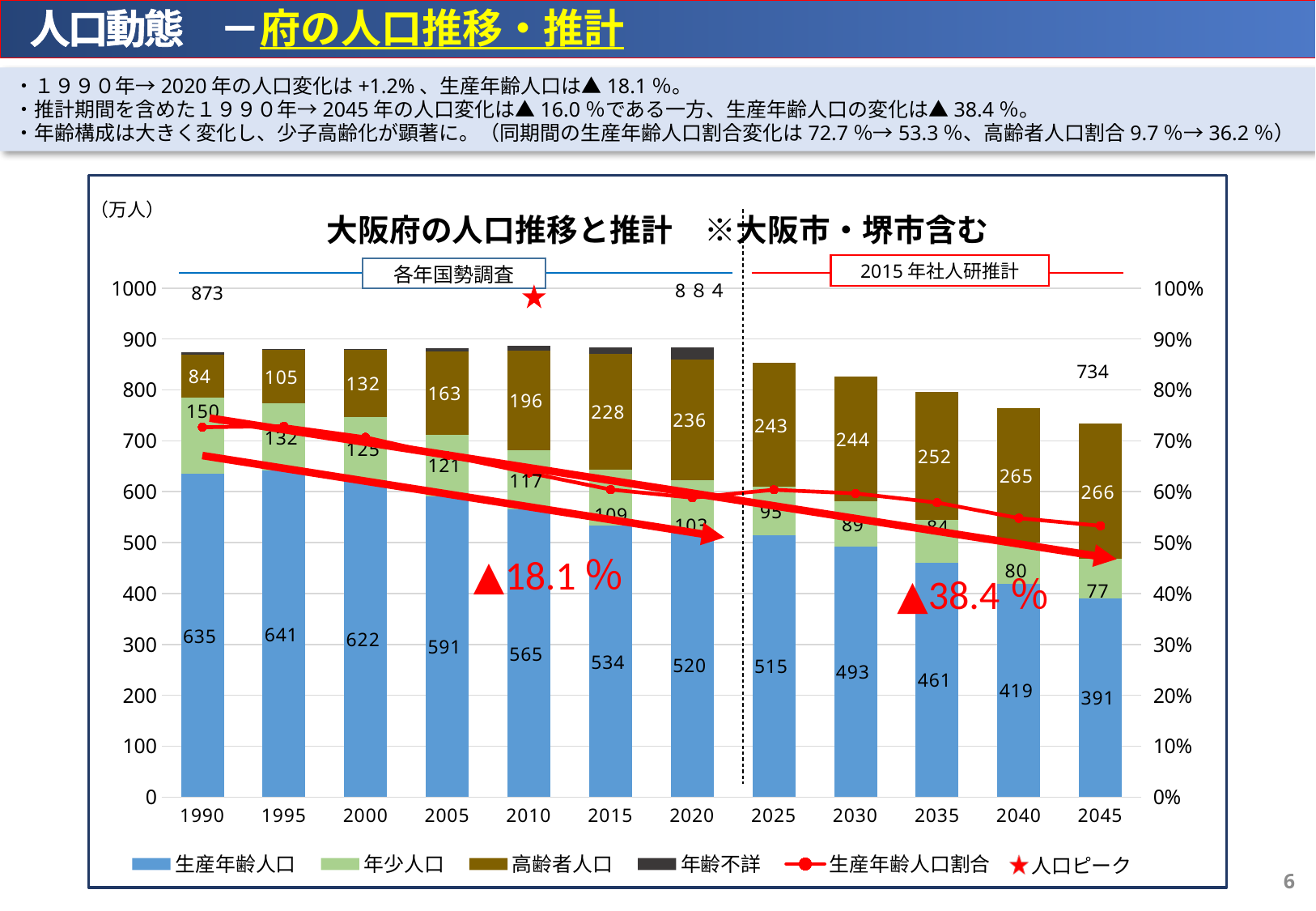
How many entries does the legend list? 6 What is the difference between the 生産年齢人口 values for 1990 and 2045? 244 Which year has the larger 高齢者人口 value, 2020 or 2025? 2025 What kind of chart is this? Stacked bar chart with a line How many years are shown on the x axis? 12 What is the value of 生産年齢人口 for 1990? 635 What is the value of 年少人口 for 2010? 117 What is the value of 高齢者人口 for 2045? 266 Which year has the lowest value for 年少人口? 2045 Does the 生産年齢人口 value rise or fall from 1995 to 2045? Fall Which year has the highest value for 生産年齢人口? 1995 What total population value is printed above the 2045 bar? 734